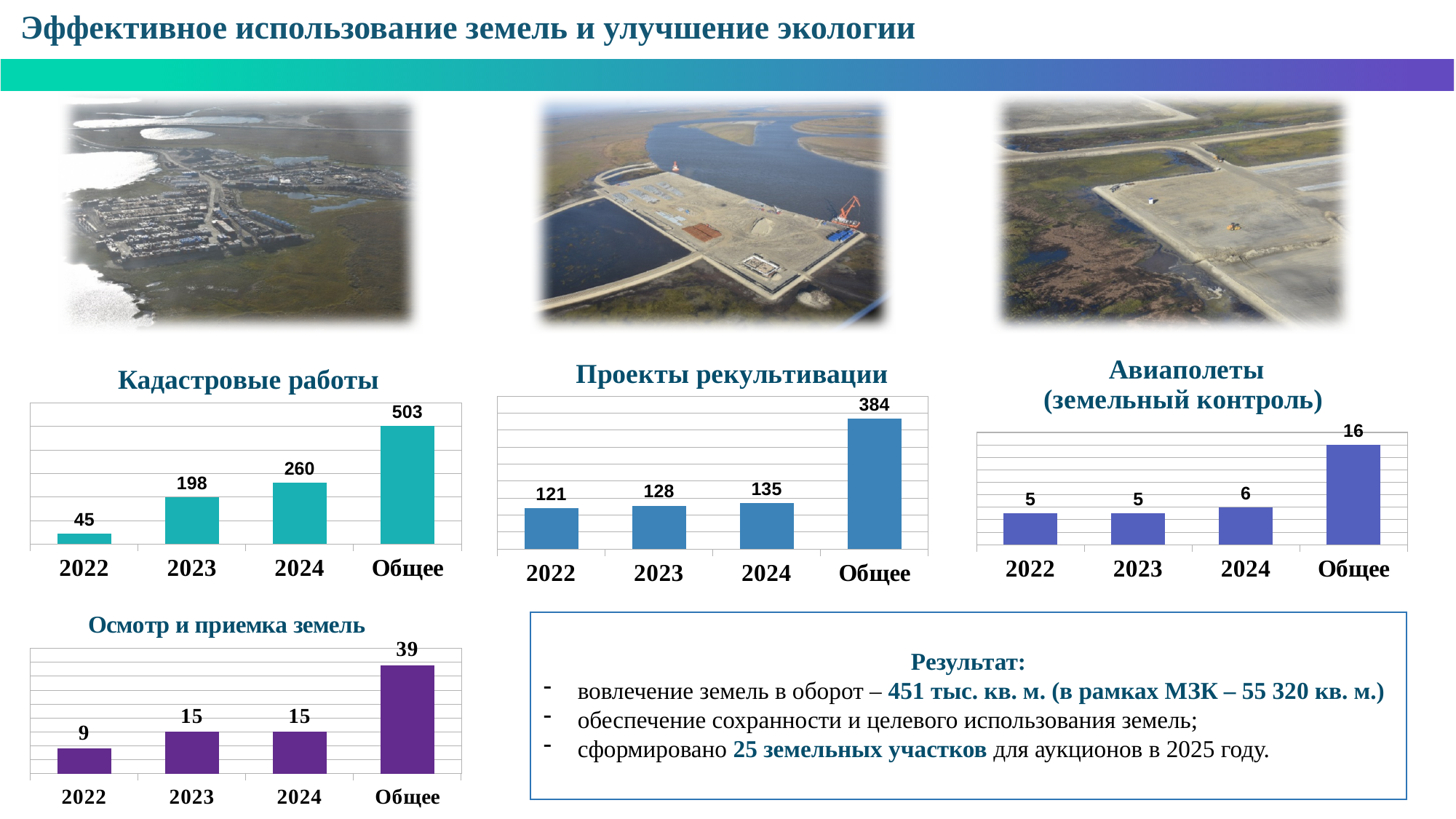
In the 'Осмотр и приемка земель' chart, how many bars are plotted? 4 Which is larger: the 2024 value in the 'Кадастровые работы' chart or the 2024 value in the 'Проекты рекультивации' chart? Кадастровые работы (260) In the 'Кадастровые работы' chart, what is the value for 2024? 260 In the 'Проекты рекультивации' chart, what is the value for 2022? 121 In the 'Авиаполеты (земельный контроль)' chart, what is the value for 2024? 6 In the 'Кадастровые работы' chart, what is the difference between the 2023 and 2022 values? 153 In the 'Проекты рекультивации' chart, which year among 2022, 2023 and 2024 has the highest value? 2024 What type of chart is the 'Кадастровые работы' chart? bar chart In the 'Проекты рекультивации' chart, do the values rise or fall from 2022 to 2024? rise In the 'Осмотр и приемка земель' chart, what is the value for 2022? 9 In the 'Авиаполеты (земельный контроль)' chart, what is the value for 'Общее'? 16 In the 'Осмотр и приемка земель' chart, which year among 2022, 2023 and 2024 has the lowest value? 2022